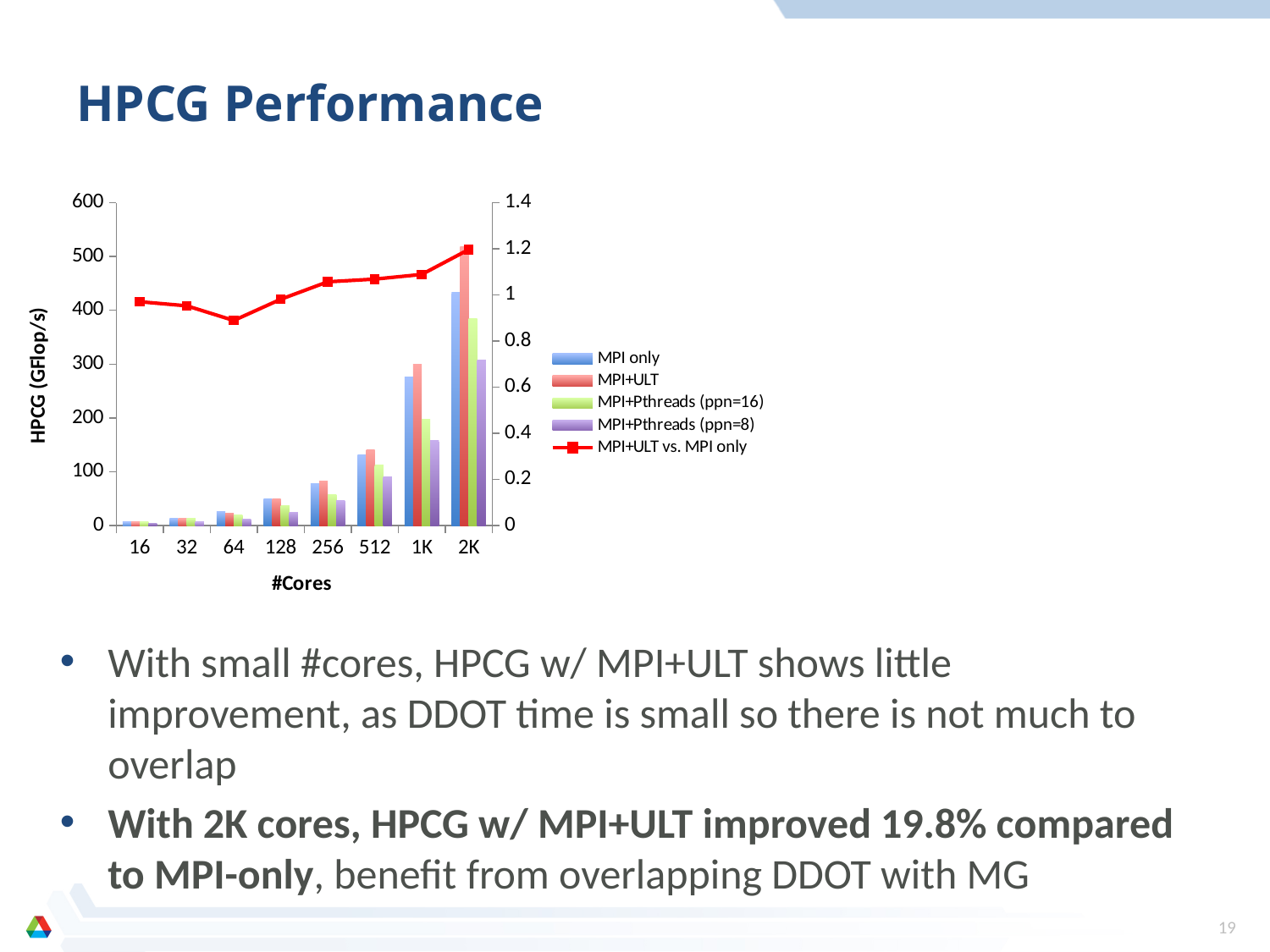
What is the label of the left vertical axis? HPCG (GFlop/s) Which series is plotted as a red line with square markers? MPI+ULT vs. MPI only How many core-count categories are shown on the x axis? 8 Do the HPCG bar values rise or fall as the number of cores increases? rise What kind of chart is shown on the slide? A combined bar and line chart At 2K cores, which is larger: MPI+Pthreads (ppn=16) or MPI+Pthreads (ppn=8)? MPI+Pthreads (ppn=16) How many series does the legend list? 5 At which core count is the MPI+ULT bar highest? 2K Is the MPI+ULT vs. MPI only ratio at 2K cores greater or less than 1? greater At which core count is the MPI+ULT vs. MPI only line at its lowest point? 64 Is the MPI only value at 2K cores greater or less than 400 GFlop/s? greater At 2K cores, which is larger: the MPI+ULT bar or the MPI only bar? MPI+ULT